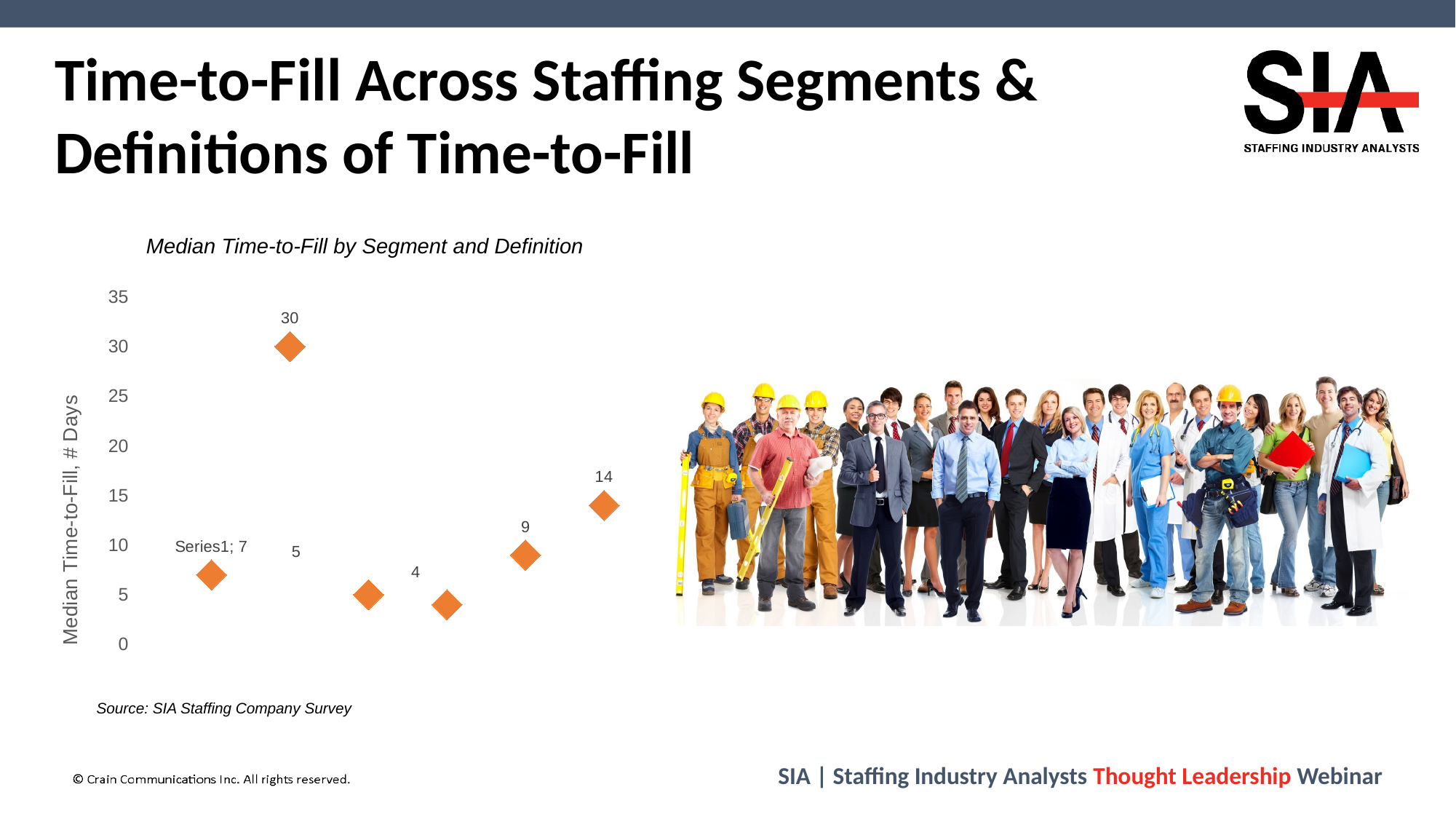
What is the maximum value shown on the vertical axis? 35 What kind of chart is shown on the slide? scatter chart Is the value of the second data point greater or less than 25? greater How many data points are plotted in the chart? 6 What is the title of the chart? Median Time-to-Fill by Segment and Definition What is the value of the first (leftmost) data point in the chart? 7 What is the lowest value plotted in the chart? 4 Which is larger: the second data point (30) or the rightmost data point (14)? 30 What is the value of the last (rightmost) data point in the chart? 14 What is the difference between the highest value (30) and the lowest value (4) in the chart? 26 What is the label of the vertical axis? Median Time-to-Fill, # Days What is the highest value plotted in the chart? 30